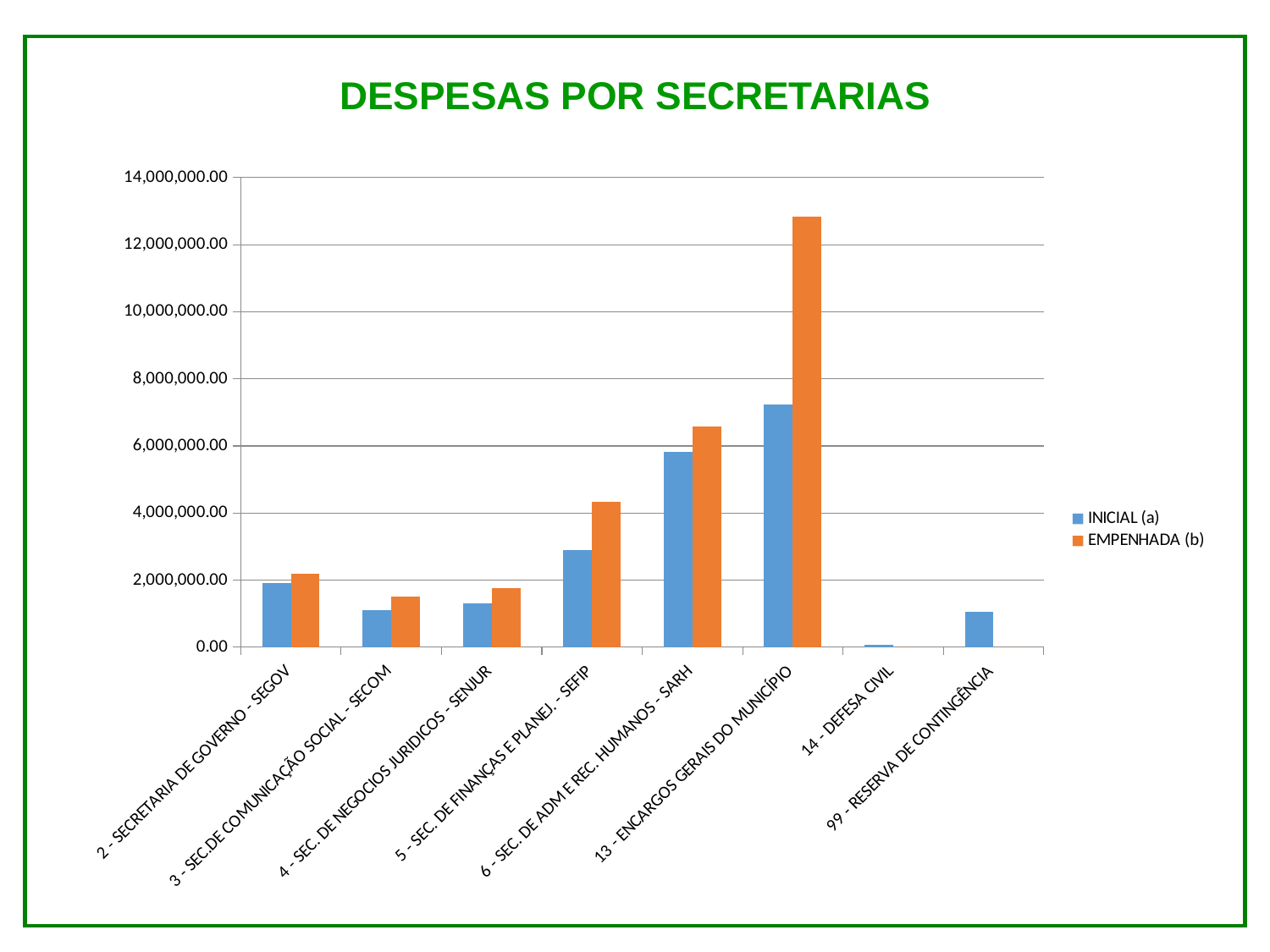
Which colour represents the EMPENHADA (b) series? orange Which category has the highest EMPENHADA (b) value? 13 - ENCARGOS GERAIS DO MUNICÍPIO Which category has the lowest INICIAL (a) value? 14 - DEFESA CIVIL What is the title of the chart? DESPESAS POR SECRETARIAS Which is larger: the EMPENHADA (b) value for 5 - SEC. DE FINANÇAS E PLANEJ. - SEFIP or the INICIAL (a) value for 6 - SEC. DE ADM E REC. HUMANOS - SARH? INICIAL (a) for 6 - SEC. DE ADM E REC. HUMANOS - SARH How many categories (secretarias) are shown on the x axis? 8 Which category has the highest INICIAL (a) value? 13 - ENCARGOS GERAIS DO MUNICÍPIO How many series does the legend list? 2 Is the EMPENHADA (b) value for 13 - ENCARGOS GERAIS DO MUNICÍPIO greater or less than 12,000,000.00? greater What type of chart is shown on the slide? bar chart Is the INICIAL (a) value for 5 - SEC. DE FINANÇAS E PLANEJ. - SEFIP greater or less than 2,000,000.00? greater Is the EMPENHADA (b) value for 6 - SEC. DE ADM E REC. HUMANOS - SARH greater or less than 6,000,000.00? greater